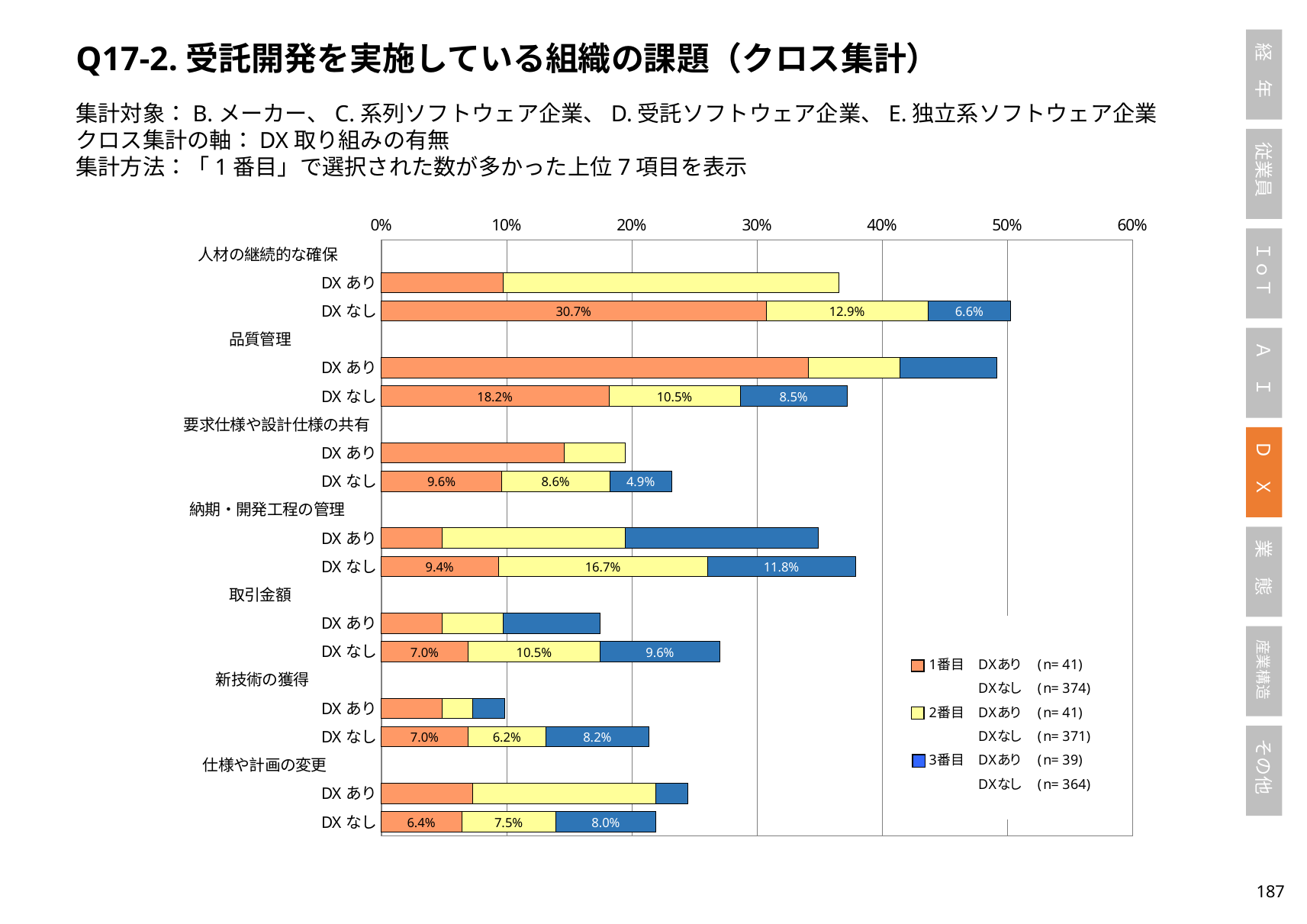
Is the total length of the 品質管理 DX あり bar greater or less than 40%? greater What is the difference between the 1番目 values for 人材の継続的な確保 DX なし and 品質管理 DX なし? 12.5% What is the total of the 人材の継続的な確保 DX なし stacked bar? 50.2% What is the 1番目 value for 人材の継続的な確保 DX なし? 30.7% For 取引金額 DX なし, which is larger: the 2番目 value or the 3番目 value? 2番目 What is the 2番目 value for 納期・開発工程の管理 DX なし? 16.7% Among the DX なし bars, which category has the highest 1番目 value? 人材の継続的な確保 How many challenge categories are shown on the chart? 7 What is the 3番目 value for 品質管理 DX なし? 8.5% Is the total length of the 取引金額 DX あり bar greater or less than 20%? less Among the DX なし bars, which category has the lowest 1番目 value? 仕様や計画の変更 How many series does the legend list? 3